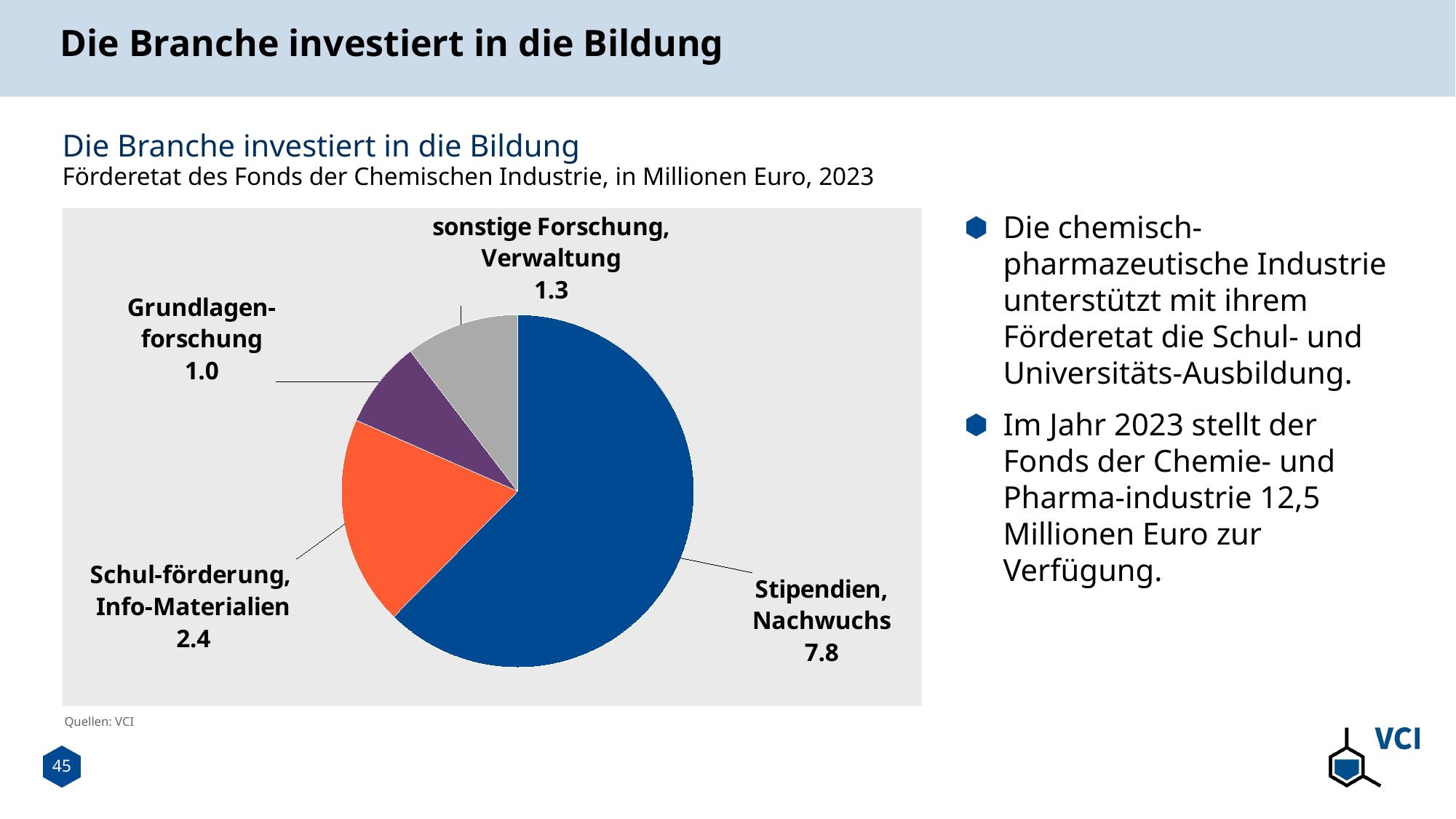
What is the value for Stipendien, Nachwuchs? 7.8 What is the total of all slices in the pie chart? 12.5 Which category has the largest slice of the pie? Stipendien, Nachwuchs What is the value for Schul-förderung, Info-Materialien? 2.4 What kind of chart is shown on the slide? Pie chart What is the value for sonstige Forschung, Verwaltung? 1.3 What is the difference between the values for Stipendien, Nachwuchs and Schul-förderung, Info-Materialien? 5.4 How many categories does the pie chart show? 4 What unit and year does the chart subtitle state the values are in? Millionen Euro, 2023 What is the value for Grundlagenforschung? 1.0 Which category has the smallest slice of the pie? Grundlagenforschung Which is larger, the value for sonstige Forschung, Verwaltung or the value for Grundlagenforschung? sonstige Forschung, Verwaltung